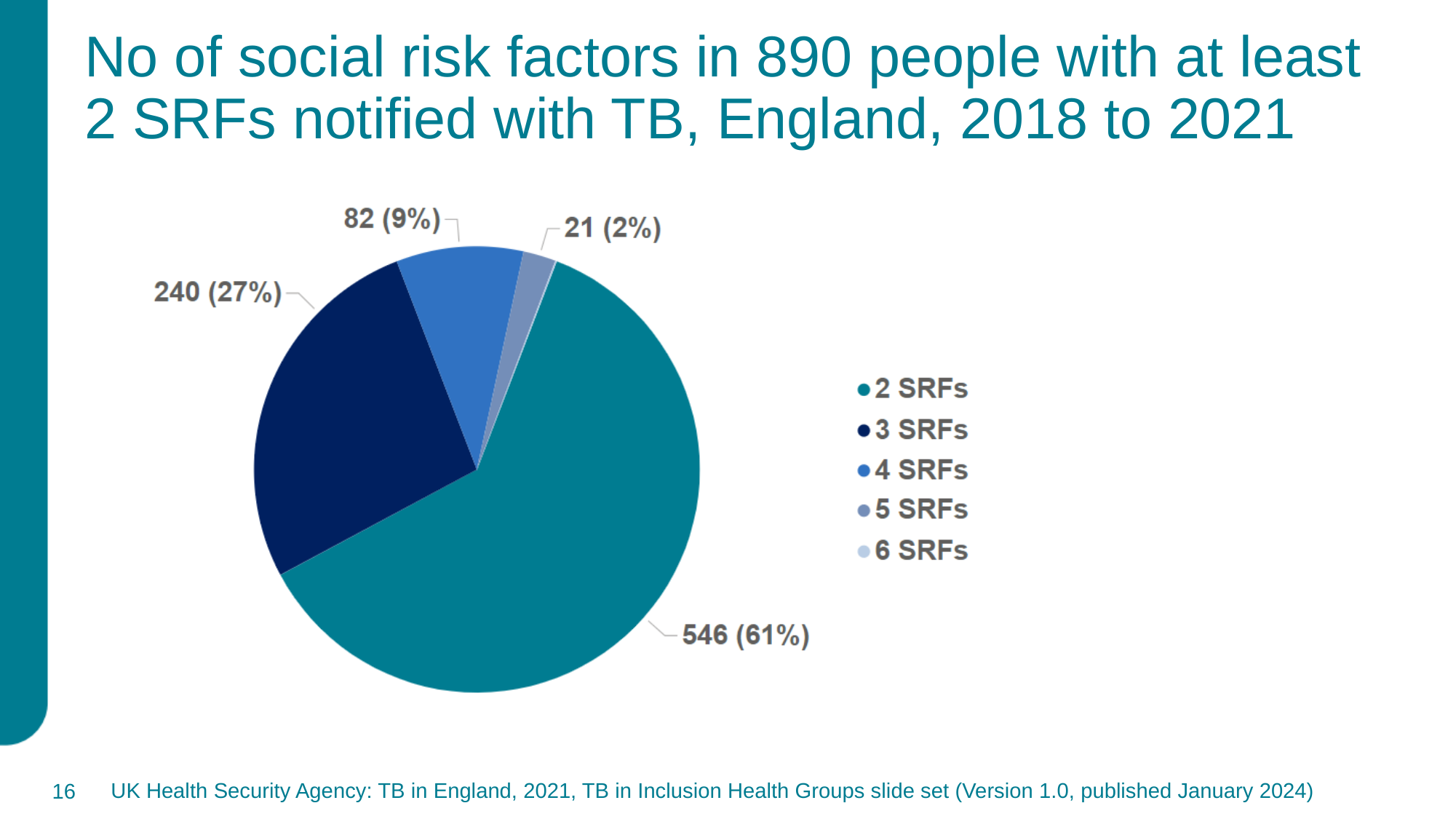
Which is larger, the number of people with 3 SRFs or with 4 SRFs? 3 SRFs Which category has the largest slice of the pie? 2 SRFs How many people had 2 SRFs? 546 What share of the pie is taken by the 3 SRFs slice? 27% Which category is shown in the teal colour on the pie chart? 2 SRFs How many people had 3 SRFs? 240 How many people had 5 SRFs? 21 What type of chart is shown on the slide? Pie chart How many categories does the legend list? 5 What is the difference between the number of people with 2 SRFs and the number with 3 SRFs? 306 How many people had 4 SRFs? 82 What percentage of people had 2 SRFs? 61%